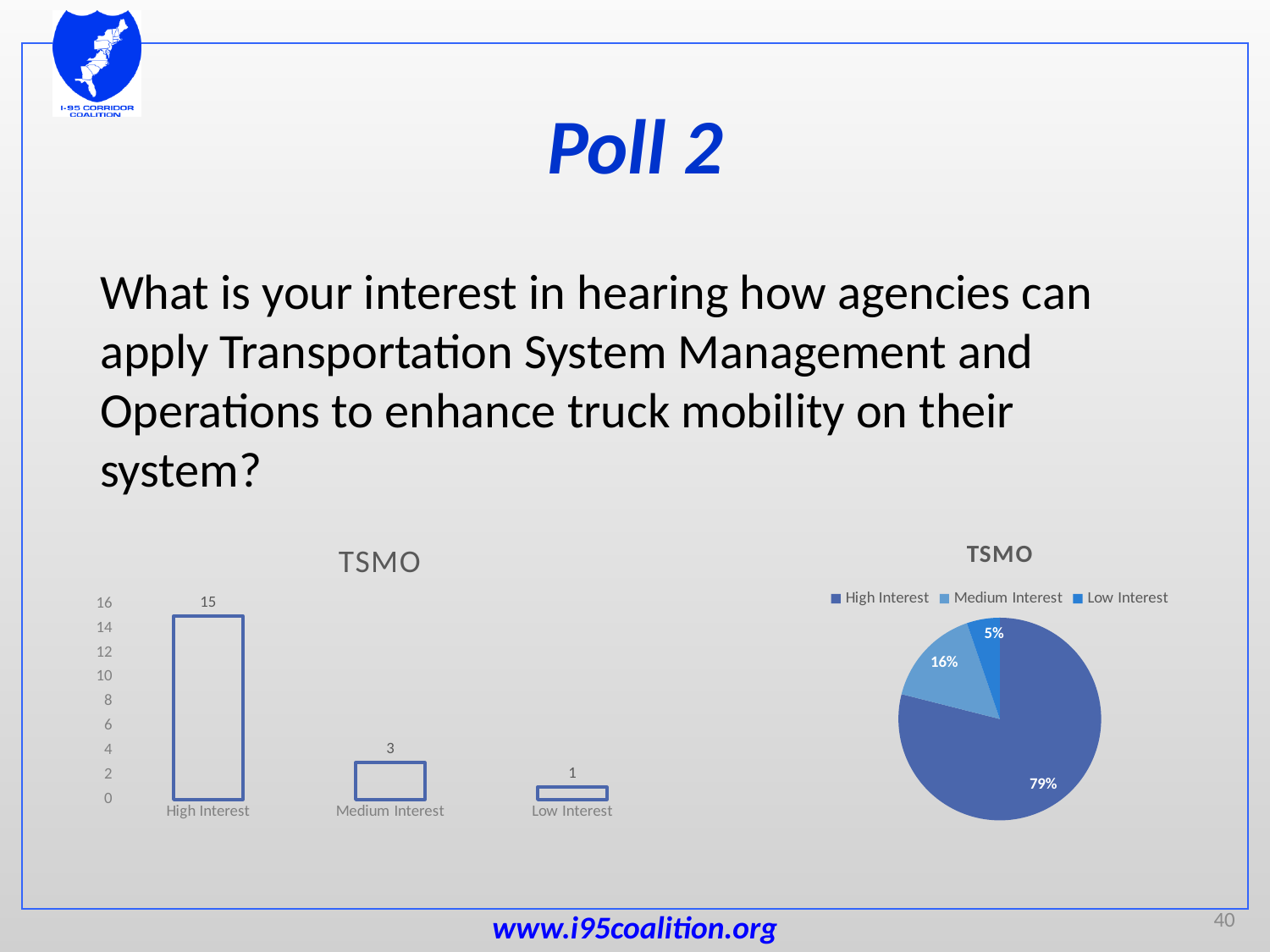
In the bar chart on the left, how many categories are shown? 3 In the bar chart on the left, what is the value for High Interest? 15 In the bar chart on the left, what is the value for Low Interest? 1 In the pie chart on the right, what share does Low Interest have? 5% In the pie chart on the right, how many entries does the legend list? 3 In the bar chart on the left, which category has the lowest value? Low Interest What is the title of the pie chart on the right? TSMO In the bar chart on the left, what is the difference between the High Interest and Medium Interest values? 12 In the bar chart on the left, which category has the highest value? High Interest In the bar chart on the left, what is the value for Medium Interest? 3 What kind of chart is the chart on the left of the slide? Bar chart In the pie chart on the right, what share does High Interest have? 79%